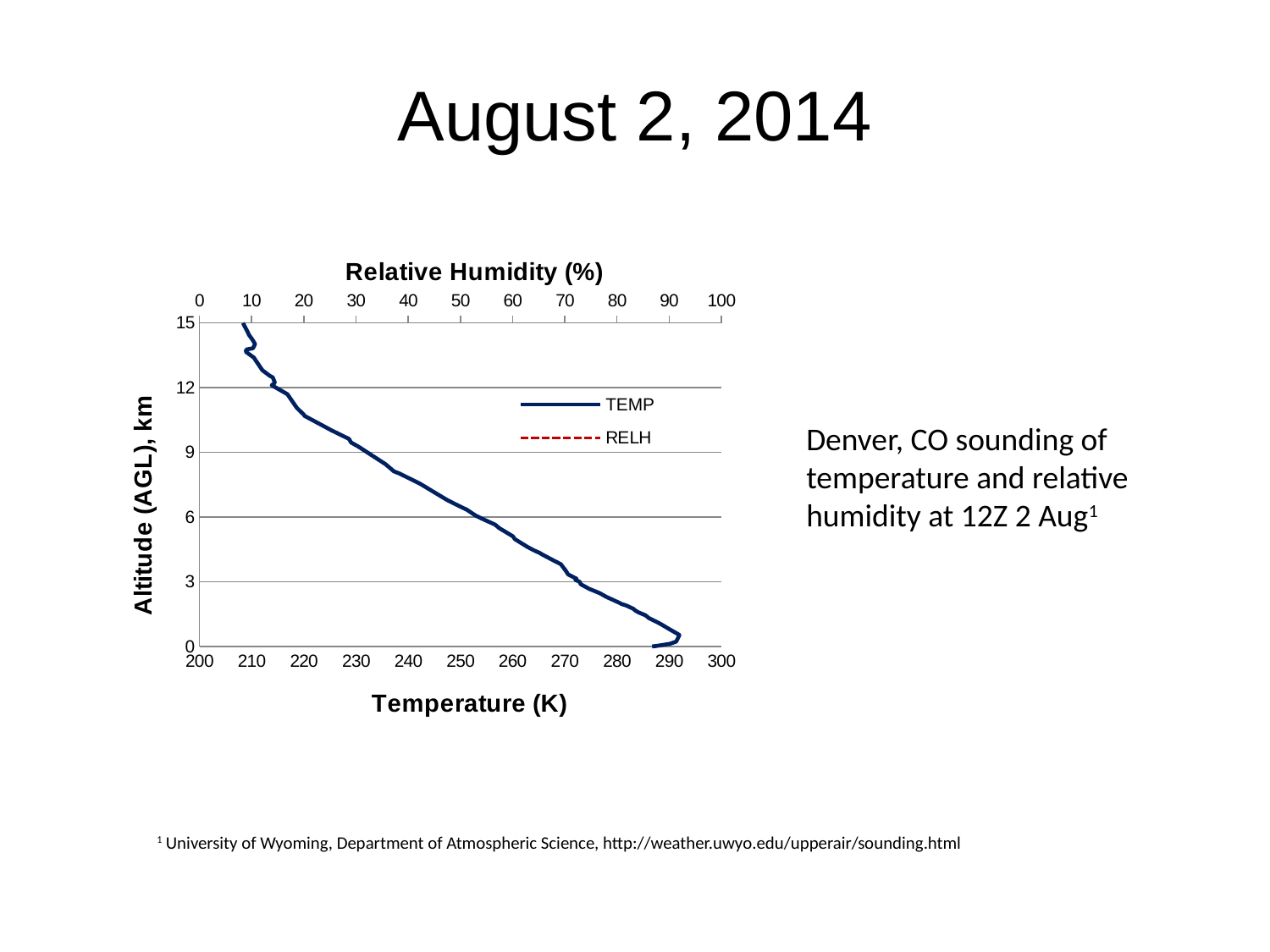
How many series does the chart legend list? 2 Is the temperature near the surface (0 km altitude) greater or less than 280 K? greater Is the temperature at an altitude of 15 km greater or less than 220 K? less As altitude increases from 0 km to 15 km, does the temperature generally rise or fall? fall Is the temperature at an altitude of 6 km greater or less than 240 K? greater What kind of chart is shown on the slide? line chart Which altitude has the higher temperature, 3 km or 12 km? 3 km What are the two series named in the chart legend? TEMP and RELH What is the title of the bottom horizontal axis of the chart? Temperature (K)